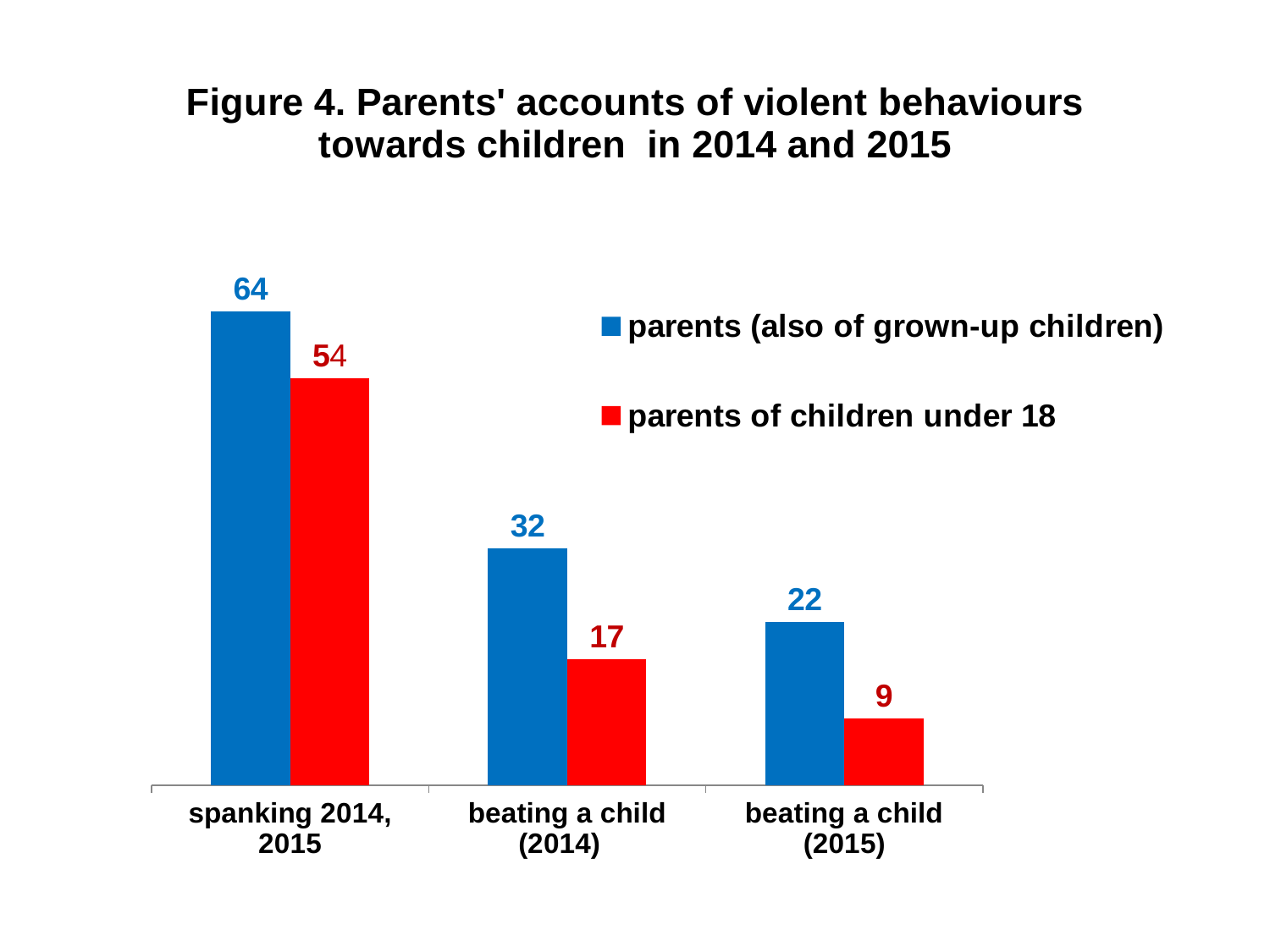
Which category has the highest value for 'parents (also of grown-up children)'? spanking 2014, 2015 How many categories are shown on the x axis? 3 How many series does the legend list? 2 What is the value for 'parents of children under 18' in the 'beating a child (2015)' category? 9 What is the difference between the two series in the 'spanking 2014, 2015' category? 10 What is the value for 'parents (also of grown-up children)' in the 'spanking 2014, 2015' category? 64 What is the value for 'parents (also of grown-up children)' in the 'beating a child (2015)' category? 22 What kind of chart is shown on the slide? bar chart What is the value for 'parents of children under 18' in the 'beating a child (2014)' category? 17 Which is larger: 'parents of children under 18' for 'spanking 2014, 2015' or 'parents (also of grown-up children)' for 'beating a child (2014)'? parents of children under 18 for spanking 2014, 2015 What is the difference between 'parents (also of grown-up children)' for 'beating a child (2014)' and 'beating a child (2015)'? 10 Which category has the lowest value for 'parents of children under 18'? beating a child (2015)